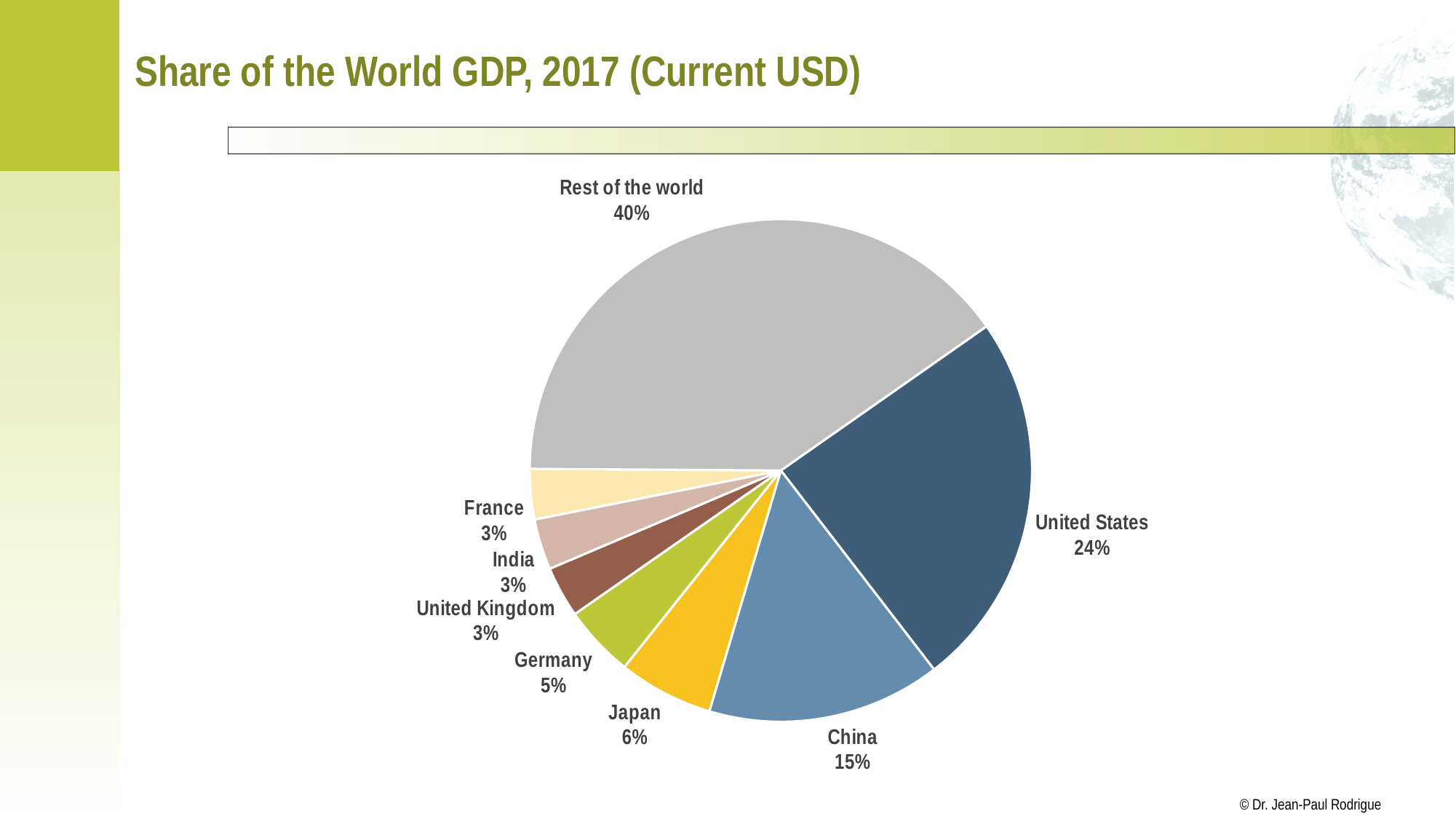
What is the title of the slide? Share of the World GDP, 2017 (Current USD) What share of world GDP does China hold? 15% What share of world GDP does Japan hold? 6% Which single country has the largest share of world GDP? United States What share of world GDP does the United States hold? 24% How many slices does the pie chart have? 8 Which slice of the pie is the largest? Rest of the world Which countries each hold a 3% share of world GDP? France, India, United Kingdom What type of chart is shown on the slide? pie chart Which has a larger share of world GDP, Japan or Germany? Japan What is the difference in share between the United States and China? 9% What share of world GDP does Germany hold? 5%